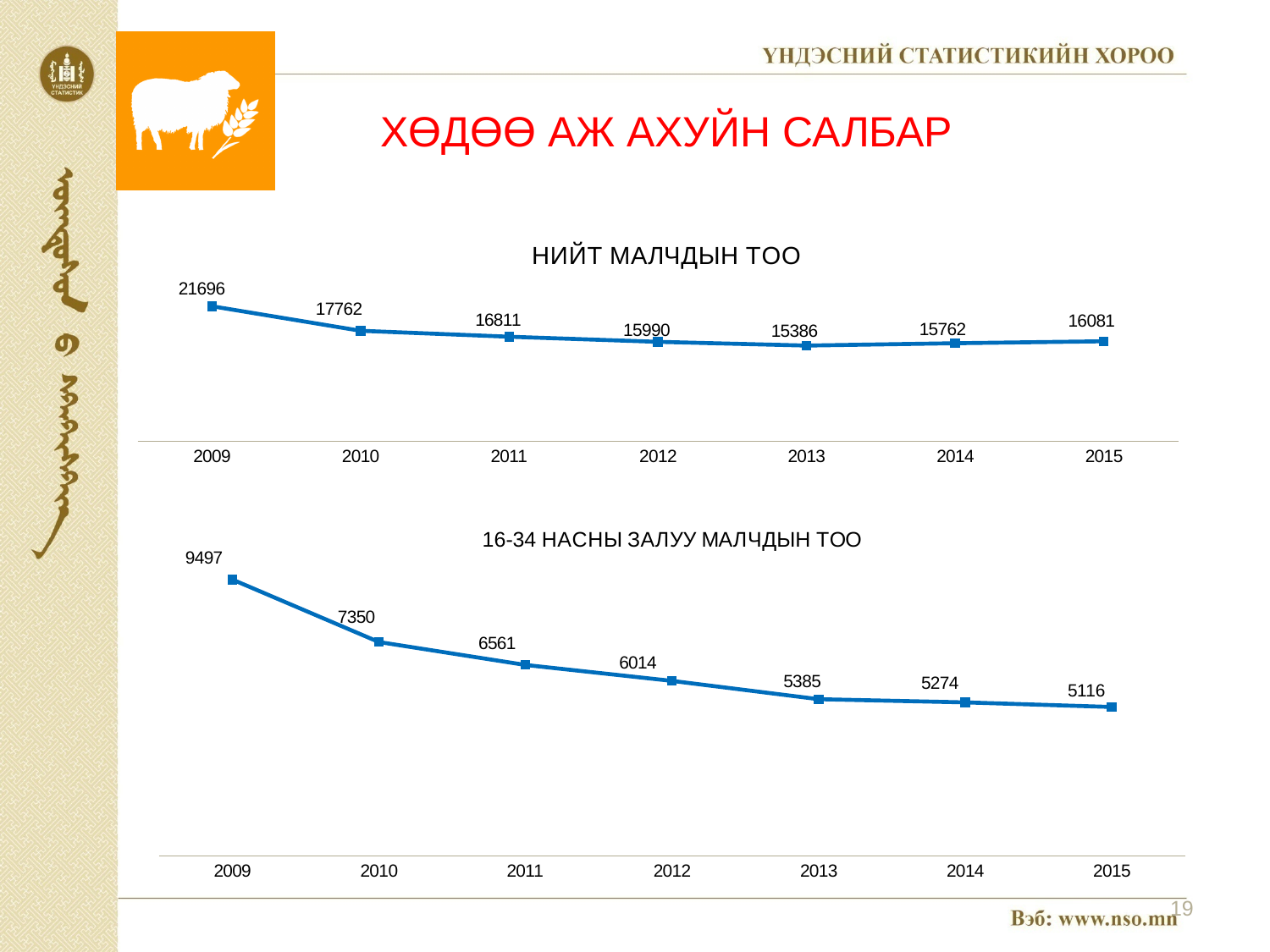
In the chart titled 'НИЙТ МАЛЧДЫН ТОО', what is the value for 2009? 21696 In the chart titled '16-34 НАСНЫ ЗАЛУУ МАЛЧДЫН ТОО', what is the value for 2012? 6014 In the chart titled '16-34 НАСНЫ ЗАЛУУ МАЛЧДЫН ТОО', do the values rise or fall from 2009 to 2015? fall In the chart titled 'НИЙТ МАЛЧДЫН ТОО', what is the difference between the 2009 and 2010 values? 3934 In the chart titled '16-34 НАСНЫ ЗАЛУУ МАЛЧДЫН ТОО', which year has the highest value? 2009 In the chart titled 'НИЙТ МАЛЧДЫН ТОО', which is larger, the value for 2014 or the value for 2015? 2015 In the chart titled 'НИЙТ МАЛЧДЫН ТОО', how many years are plotted? 7 In the chart titled '16-34 НАСНЫ ЗАЛУУ МАЛЧДЫН ТОО', which year has the lowest value? 2015 In the chart titled 'НИЙТ МАЛЧДЫН ТОО', which year has the lowest value? 2013 In the chart titled 'НИЙТ МАЛЧДЫН ТОО', what is the value for 2013? 15386 In the chart titled '16-34 НАСНЫ ЗАЛУУ МАЛЧДЫН ТОО', what is the difference between the 2009 and 2015 values? 4381 What kind of chart is the chart titled '16-34 НАСНЫ ЗАЛУУ МАЛЧДЫН ТОО'? line chart